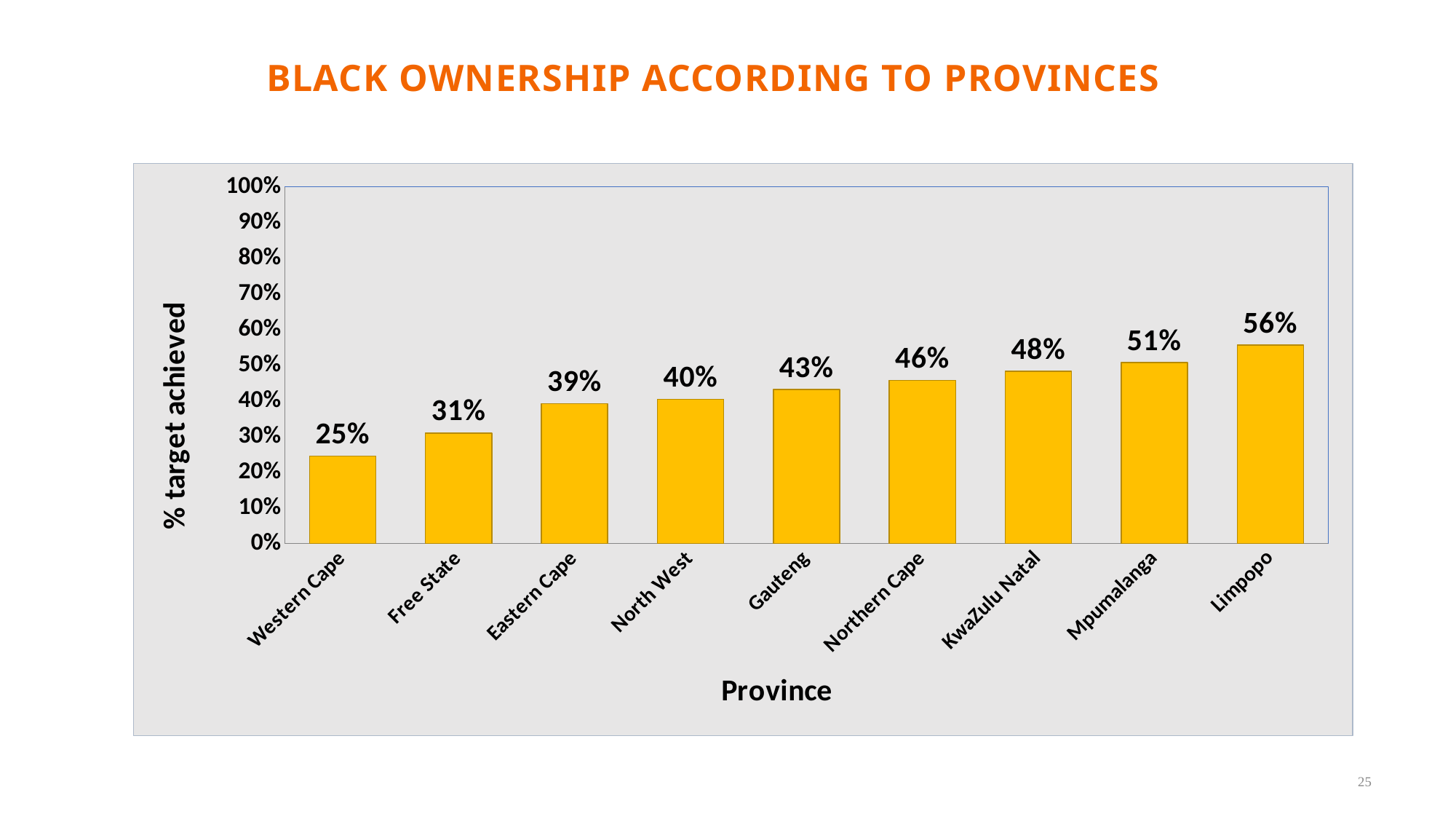
Which has a higher % target achieved, Northern Cape or North West? Northern Cape Which province has the highest % target achieved? Limpopo Is the value for Eastern Cape greater or less than 50%? less Do the values rise or fall from left to right across the provinces? Rise Which province has the lowest % target achieved? Western Cape What is the % target achieved for KwaZulu Natal? 48% How many provinces are shown on the chart? 9 What is the % target achieved for Gauteng? 43% What is the difference in % target achieved between Mpumalanga and Free State? 20% What kind of chart is shown on the slide? Bar chart What is the difference in % target achieved between Limpopo and Western Cape? 31% What is the % target achieved for Western Cape? 25%